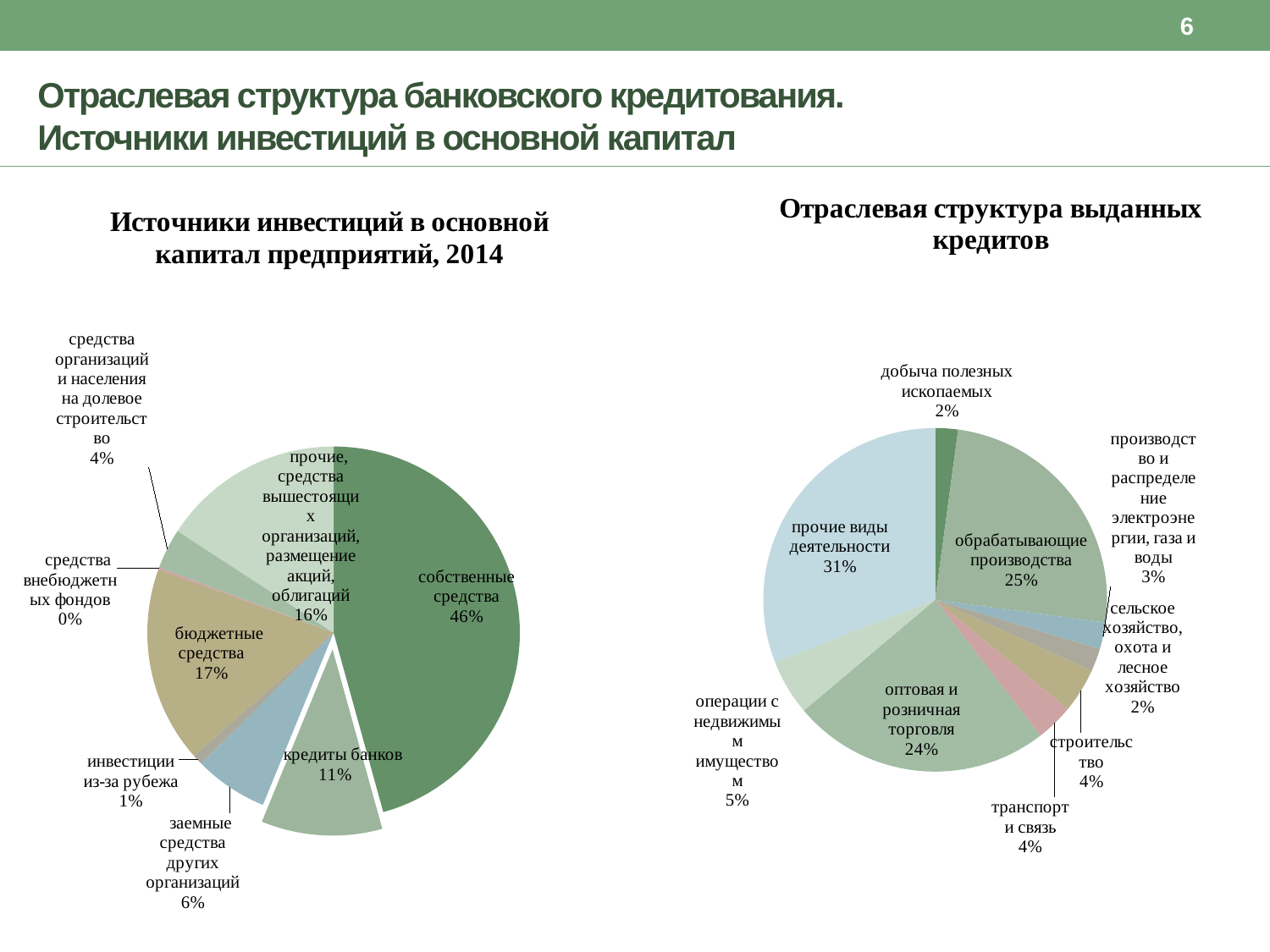
On the chart 'Источники инвестиций в основной капитал предприятий, 2014', which category has the smallest share? средства внебюджетных фондов On the chart 'Источники инвестиций в основной капитал предприятий, 2014', what share is 'собственные средства'? 46% What type of chart is 'Отраслевая структура выданных кредитов'? Pie chart On the chart 'Отраслевая структура выданных кредитов', what share is 'операции с недвижимым имуществом'? 5% On the chart 'Отраслевая структура выданных кредитов', which is larger: 'обрабатывающие производства' or 'оптовая и розничная торговля'? обрабатывающие производства On the chart 'Отраслевая структура выданных кредитов', what share is 'оптовая и розничная торговля'? 24% How many slices does the chart 'Отраслевая структура выданных кредитов' have? 9 On the chart 'Источники инвестиций в основной капитал предприятий, 2014', what is the difference between 'бюджетные средства' and 'кредиты банков'? 6 percentage points On the chart 'Источники инвестиций в основной капитал предприятий, 2014', what share is 'кредиты банков'? 11% On the chart 'Отраслевая структура выданных кредитов', which category has the largest share? прочие виды деятельности On the chart 'Источники инвестиций в основной капитал предприятий, 2014', which category has the largest share? собственные средства How many slices does the chart 'Источники инвестиций в основной капитал предприятий, 2014' have? 8